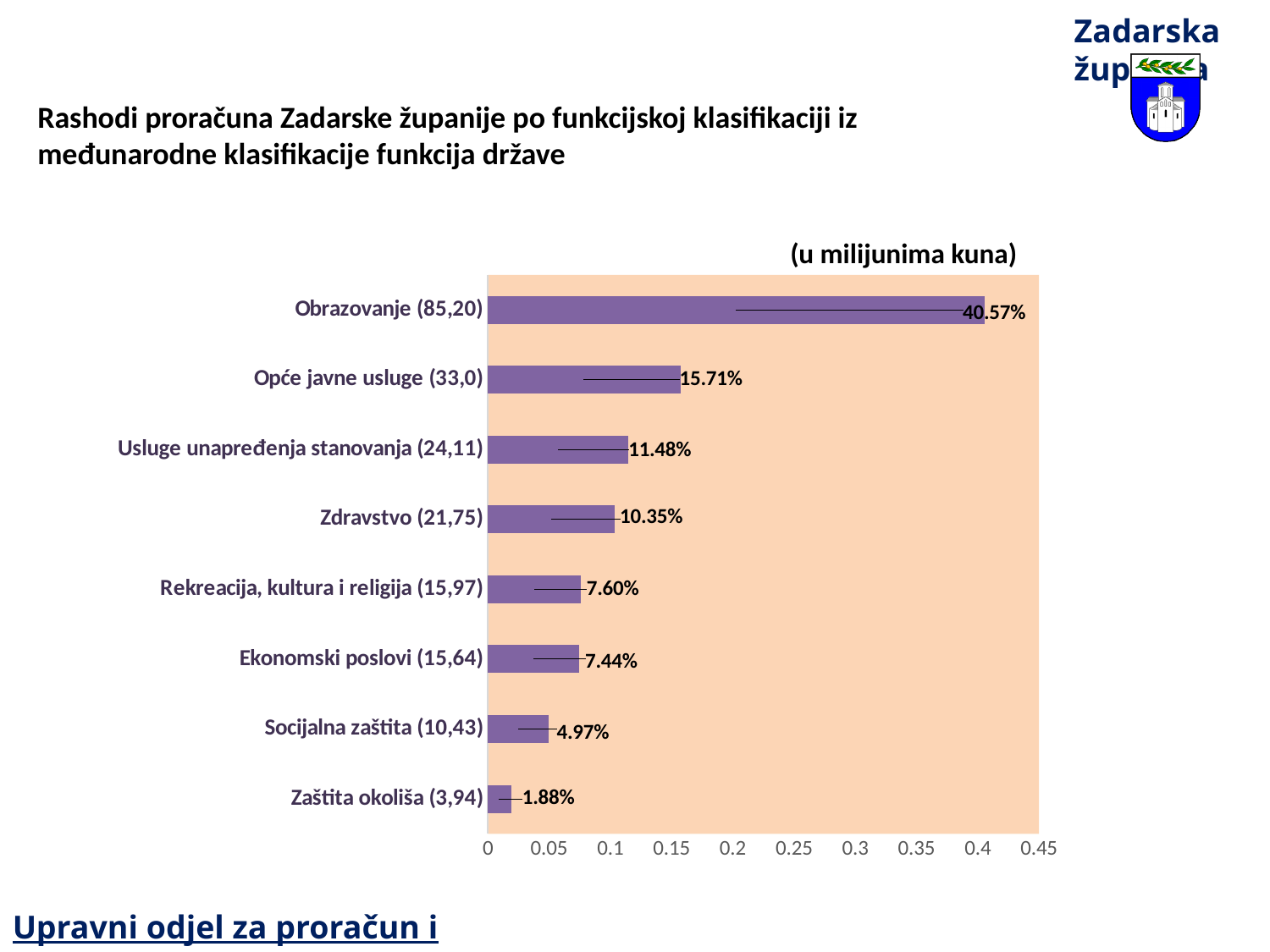
Is the bar for Obrazovanje (85,20) greater or less than 0.4 on the axis? greater What is the data label for Zdravstvo (21,75)? 10.35% What kind of chart is shown on the slide? bar chart Which category has the lowest value in the chart? Zaštita okoliša (3,94) What is the data label for Obrazovanje (85,20)? 40.57% What unit note is shown above the chart? (u milijunima kuna) What is the data label for Socijalna zaštita (10,43)? 4.97% Which category has the highest value in the chart? Obrazovanje (85,20) Is the bar for Opće javne usluge (33,0) greater or less than 0.2 on the axis? less Which has the larger value: Usluge unapređenja stanovanja (24,11) or Zdravstvo (21,75)? Usluge unapređenja stanovanja (24,11) How many categories are plotted in the chart? 8 What is the difference between the data labels for Obrazovanje (85,20) and Opće javne usluge (33,0)? 24.86%